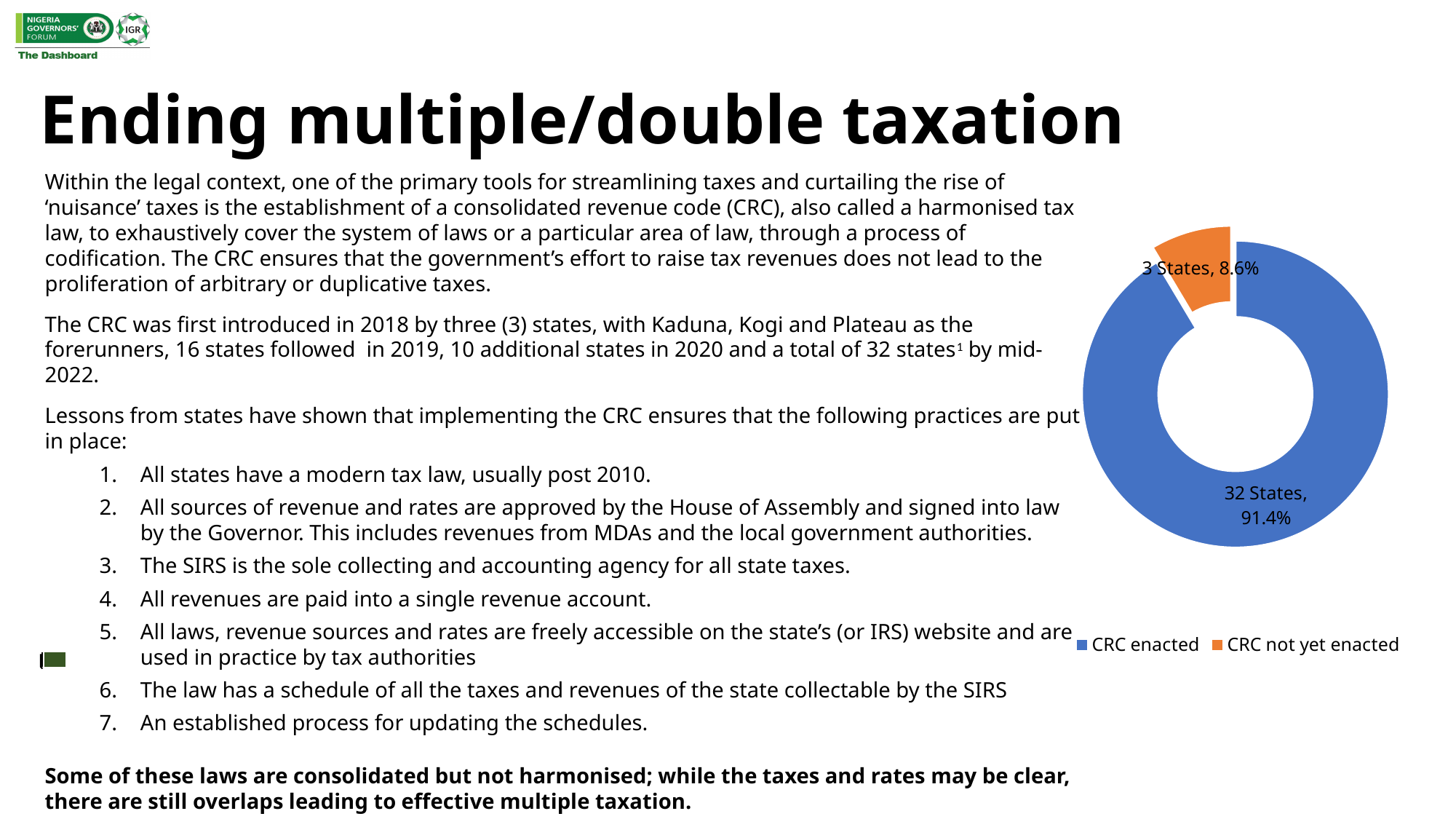
How many states have enacted a CRC according to the chart? 32 States How many states have not yet enacted a CRC according to the chart? 3 States What colour represents 'CRC not yet enacted' in the chart? Orange How many more states have enacted a CRC than have not yet enacted one? 29 Which category has the smaller share of the chart? CRC not yet enacted What percentage of states have not yet enacted a CRC? 8.6% Which category has the larger share of the chart? CRC enacted What colour represents 'CRC enacted' in the chart? Blue What percentage of states have enacted a CRC? 91.4% What kind of chart is shown on the slide? Doughnut (pie) chart What is the total number of states represented in the chart? 35 How many categories does the chart's legend list? 2